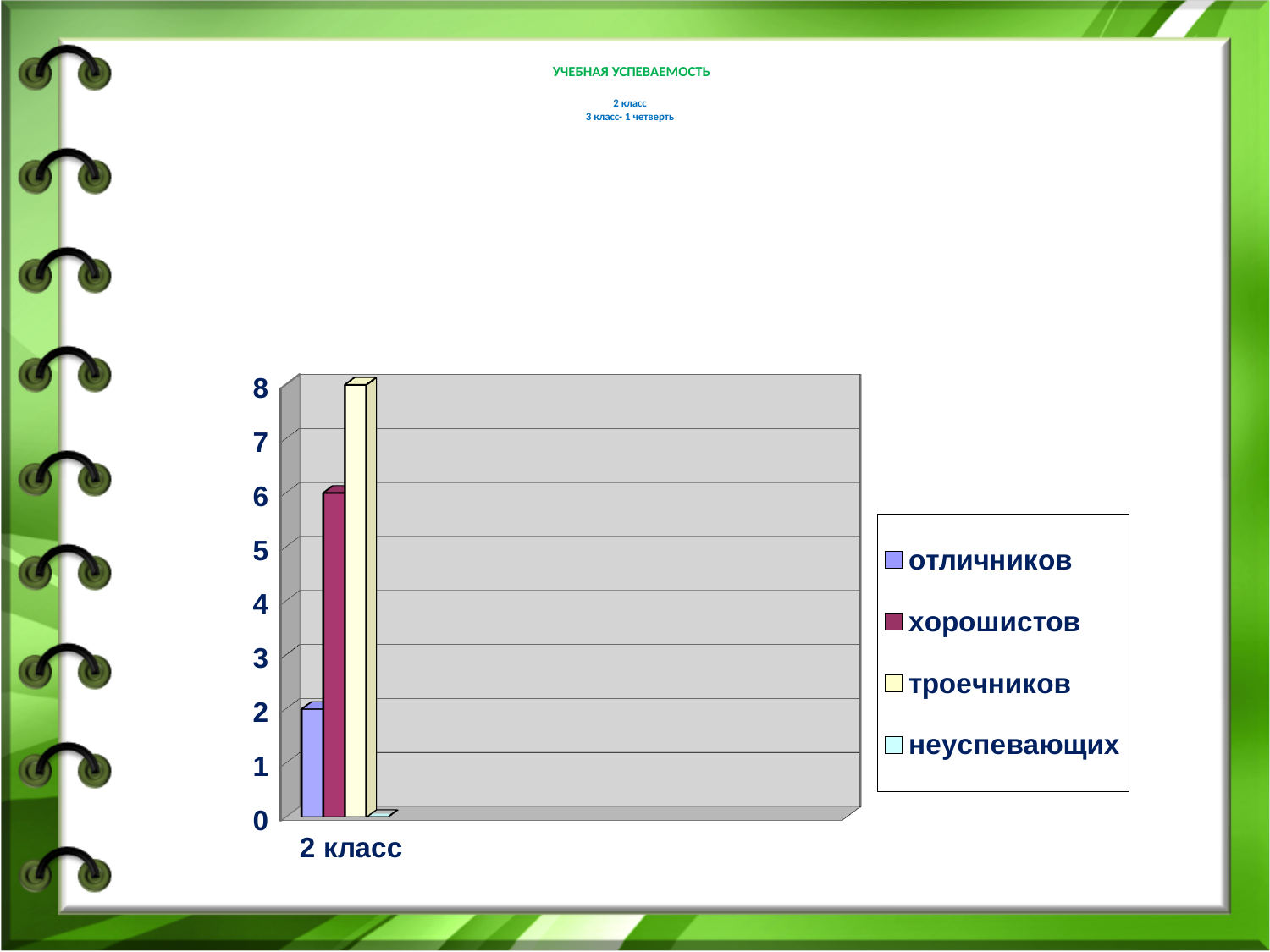
Is the value for отличников greater or less than 3? less What is the highest value shown on the y axis? 8 Is the value for троечников greater or less than 7? greater Which series has the highest value for 2 класс? троечников Which is larger for 2 класс: хорошистов or отличников? хорошистов What kind of chart is shown on the slide? bar chart What is the category label shown on the x axis? 2 класс How many series does the legend list? 4 How many categories are shown on the x axis? 1 Which is larger for 2 класс: троечников or хорошистов? троечников Which series has the lowest value for 2 класс? неуспевающих Is the value for хорошистов greater or less than 4? greater